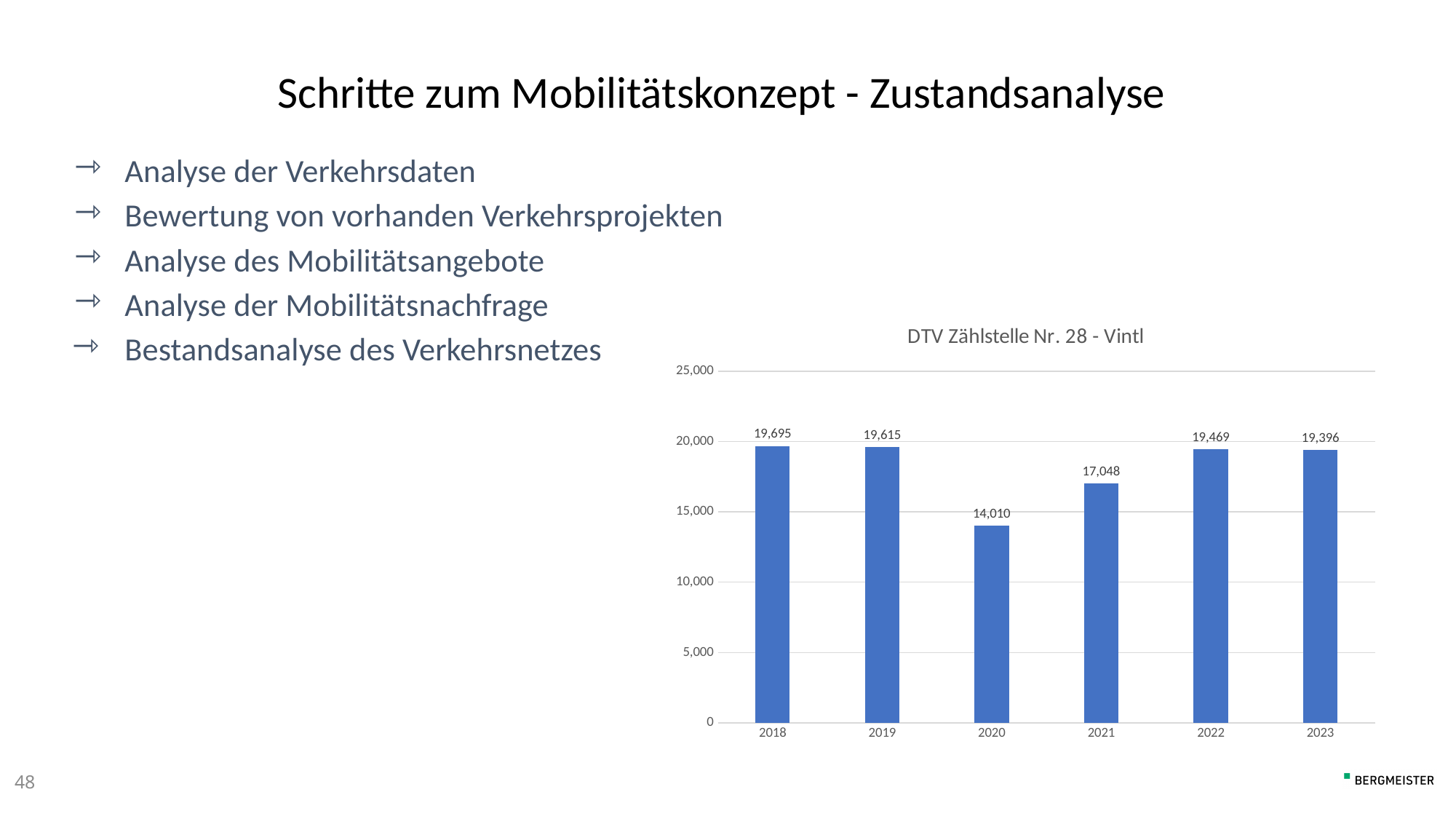
What is the value for 2023? 19,396 What is the value for 2021? 17,048 Which is larger, the value for 2021 or the value for 2022? 2022 What kind of chart is this? bar chart Which year has the lowest value? 2020 How many years are shown on the x axis? 6 What is the title of the chart? DTV Zählstelle Nr. 28 - Vintl Is the value for 2020 greater or less than 15,000? less What is the value for 2020? 14,010 What is the difference between the values for 2019 and 2020? 5,605 Which year has the highest value? 2018 What is the value for 2018? 19,695